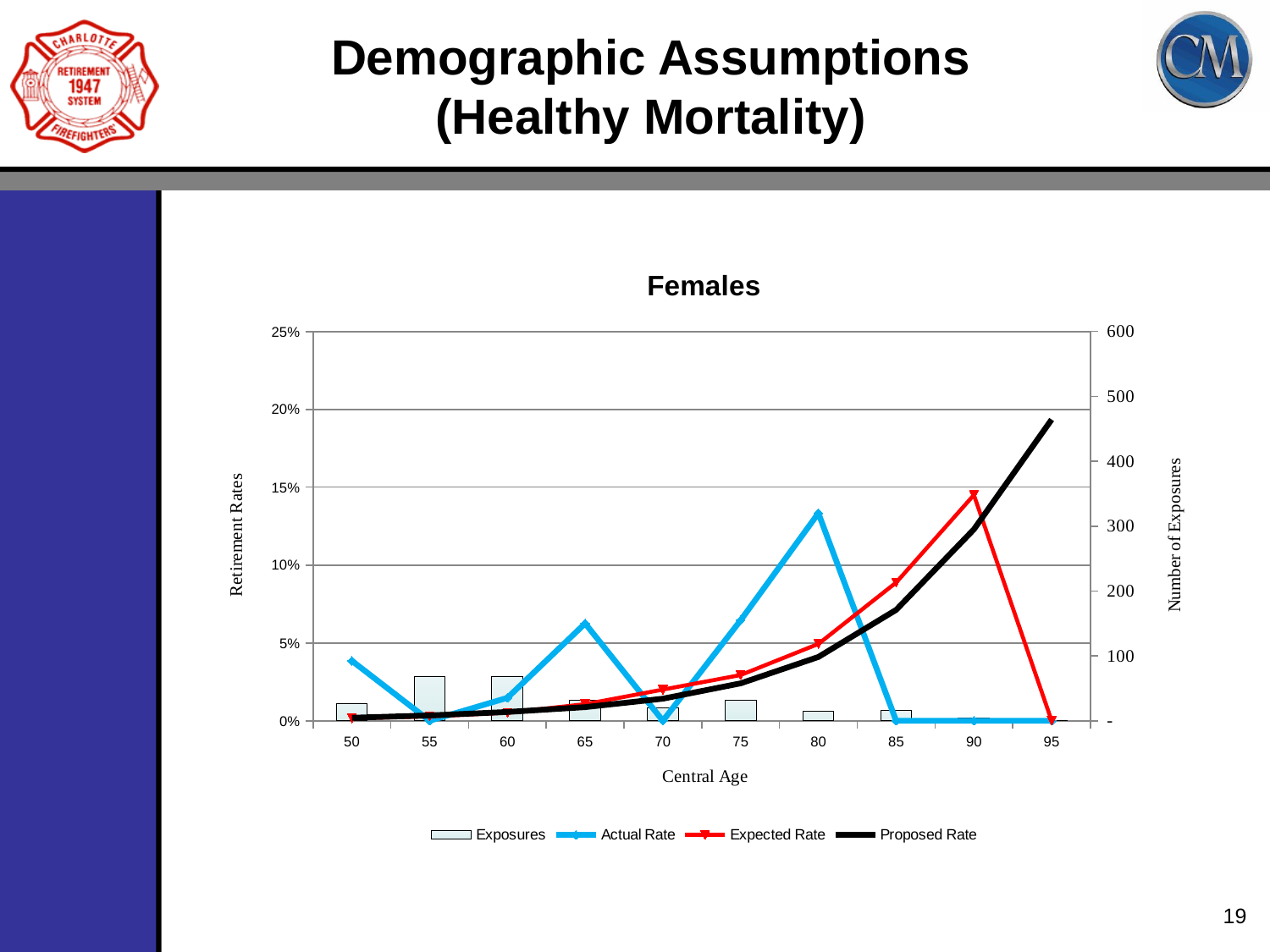
Is the Proposed Rate at central age 95 greater or less than 15%? greater What is the title of the chart? Females At central age 90, which is larger, the Expected Rate or the Actual Rate? Expected Rate How many central age categories are shown on the x axis? 10 How many series does the chart legend list? 4 At which central age is the Expected Rate highest? 90 What kind of chart is this? Combined bar and line chart Does the Proposed Rate rise or fall as central age increases from 50 to 95? rises Is the number of exposures at central age 55 greater or less than 100? less At which central age is the Actual Rate highest? 80 At which central age is the Proposed Rate highest? 95 Is the Actual Rate at central age 80 greater or less than 10%? greater